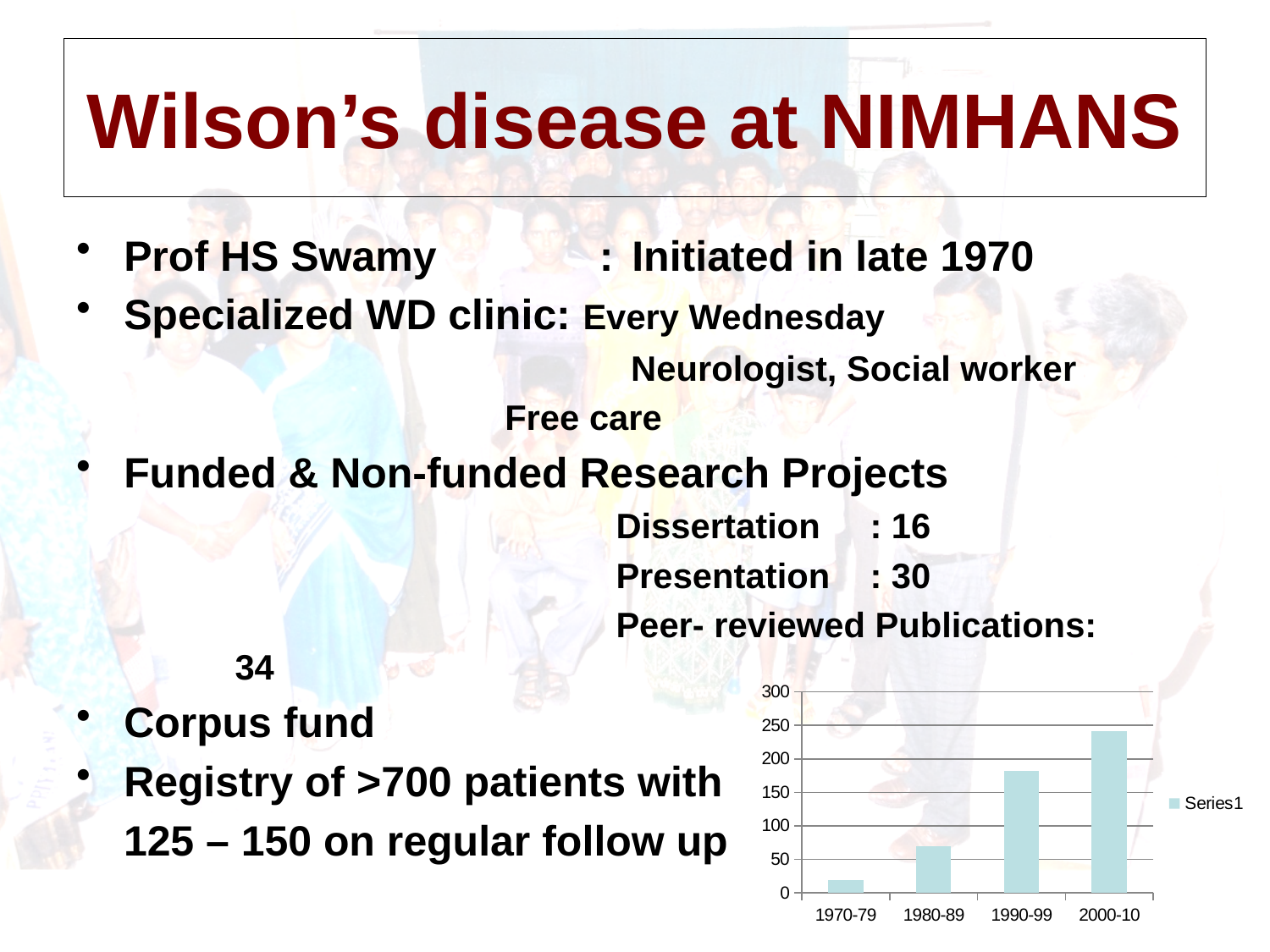
Is the value for 1990-99 greater or less than 150? greater Is the value for 1970-79 greater or less than 50? less What kind of chart is shown on the slide? bar chart Which is larger in the chart, the value for 1980-89 or the value for 1990-99? 1990-99 How many series does the chart legend list? 1 Which category has the highest bar in the chart? 2000-10 What is the name of the series shown in the chart legend? Series1 How many categories are shown on the x axis of the chart? 4 Which category has the lowest bar in the chart? 1970-79 Is the value for 1980-89 greater or less than 100? less Do the values in the chart rise or fall from 1970-79 to 2000-10? rise